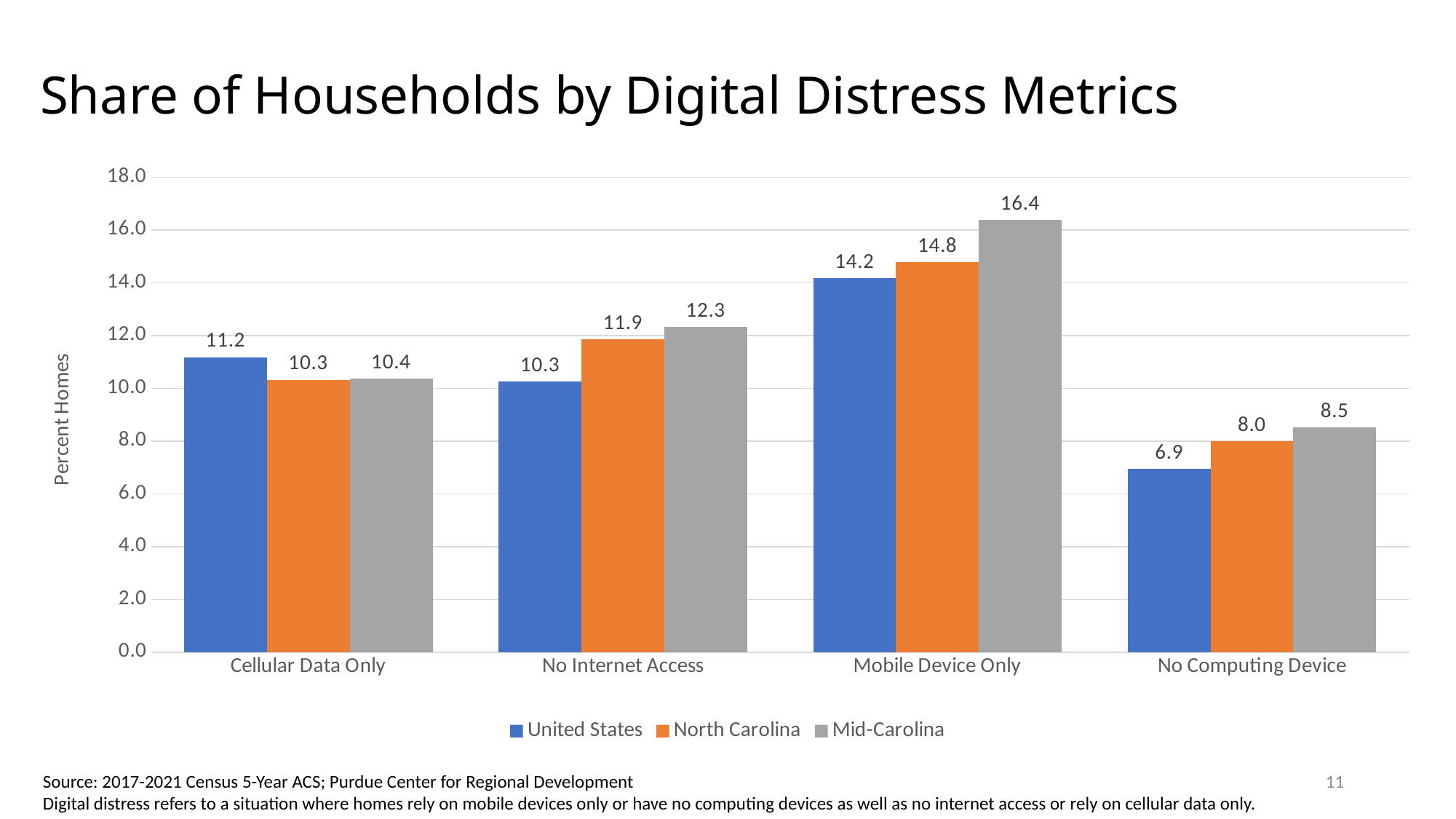
Which category has the highest value for Mid-Carolina? Mobile Device Only What is the value for Mid-Carolina in the Mobile Device Only category? 16.4 What is the value for United States in the No Computing Device category? 6.9 What is the value for North Carolina in the No Internet Access category? 11.9 How many categories are shown on the x axis? 4 Which category has the lowest value for United States? No Computing Device What kind of chart is shown on the slide? bar chart Is the value for North Carolina in the No Computing Device category greater or less than 10.0? less Which is larger in the Cellular Data Only category: United States or North Carolina? United States What is the label of the y axis? Percent Homes How many series does the legend list? 3 What is the difference between the Mid-Carolina and United States values in the Mobile Device Only category? 2.2